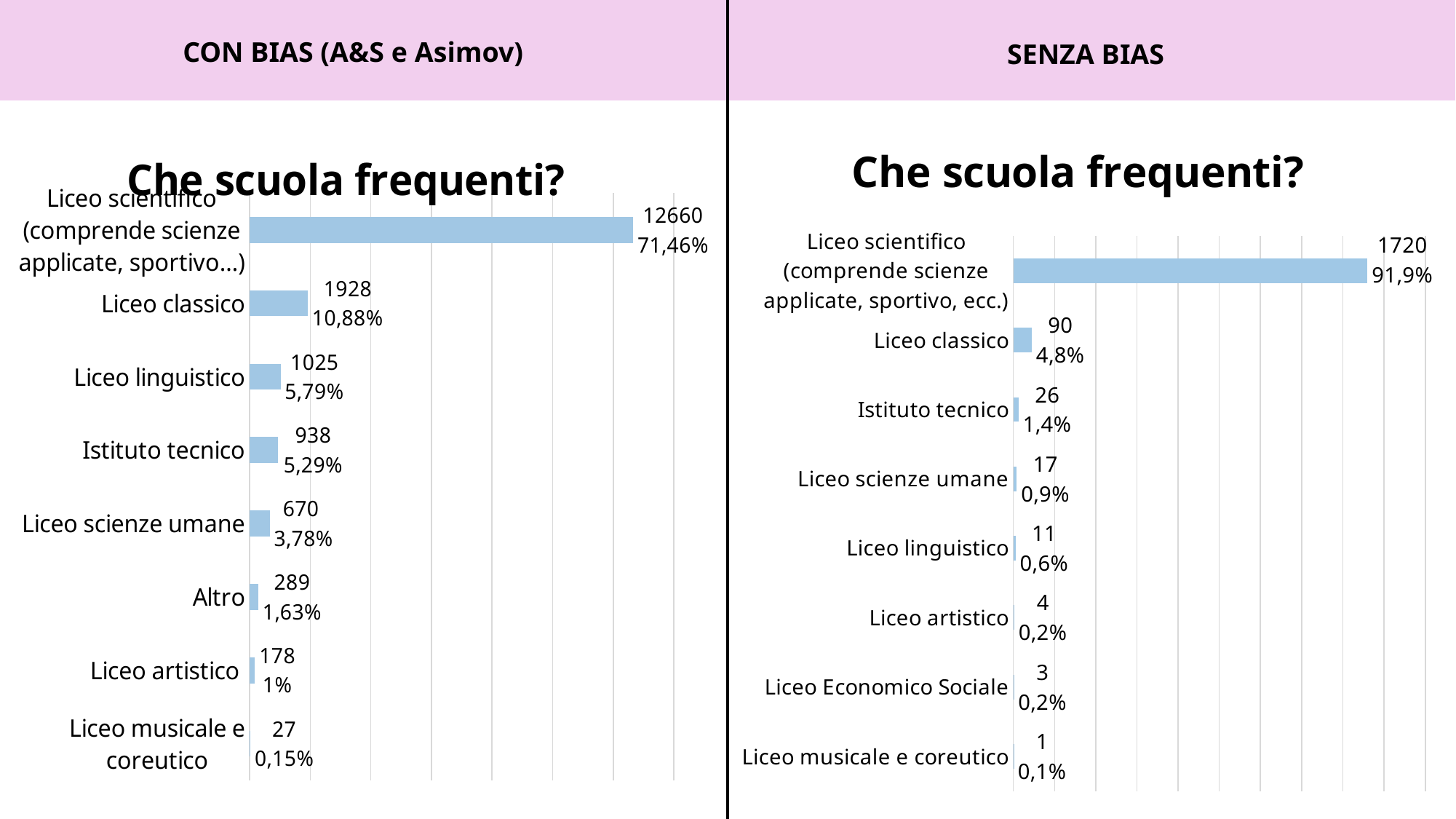
In the left chart (CON BIAS), what is the difference between the counts for Liceo linguistico and Istituto tecnico? 87 In the left chart (CON BIAS), which school category has the lowest count? Liceo musicale e coreutico In the right chart (SENZA BIAS), what percentage is shown for Liceo scientifico? 91,9% What is the title of the chart on the right side (SENZA BIAS)? Che scuola frequenti? In the right chart (SENZA BIAS), what is the difference between the counts for Liceo classico and Istituto tecnico? 64 In the left chart (CON BIAS), what is the count for Liceo classico? 1928 How many school categories are shown in the right chart (SENZA BIAS)? 8 In the left chart (CON BIAS), which has a larger count, Liceo scienze umane or Altro? Liceo scienze umane In the right chart (SENZA BIAS), which school category has the highest count? Liceo scientifico (comprende scienze applicate, sportivo, ecc.) In the left chart (CON BIAS), what percentage is shown for Liceo linguistico? 5,79% What type of chart is used on the left side (CON BIAS)? Bar chart In the right chart (SENZA BIAS), what is the count for Istituto tecnico? 26